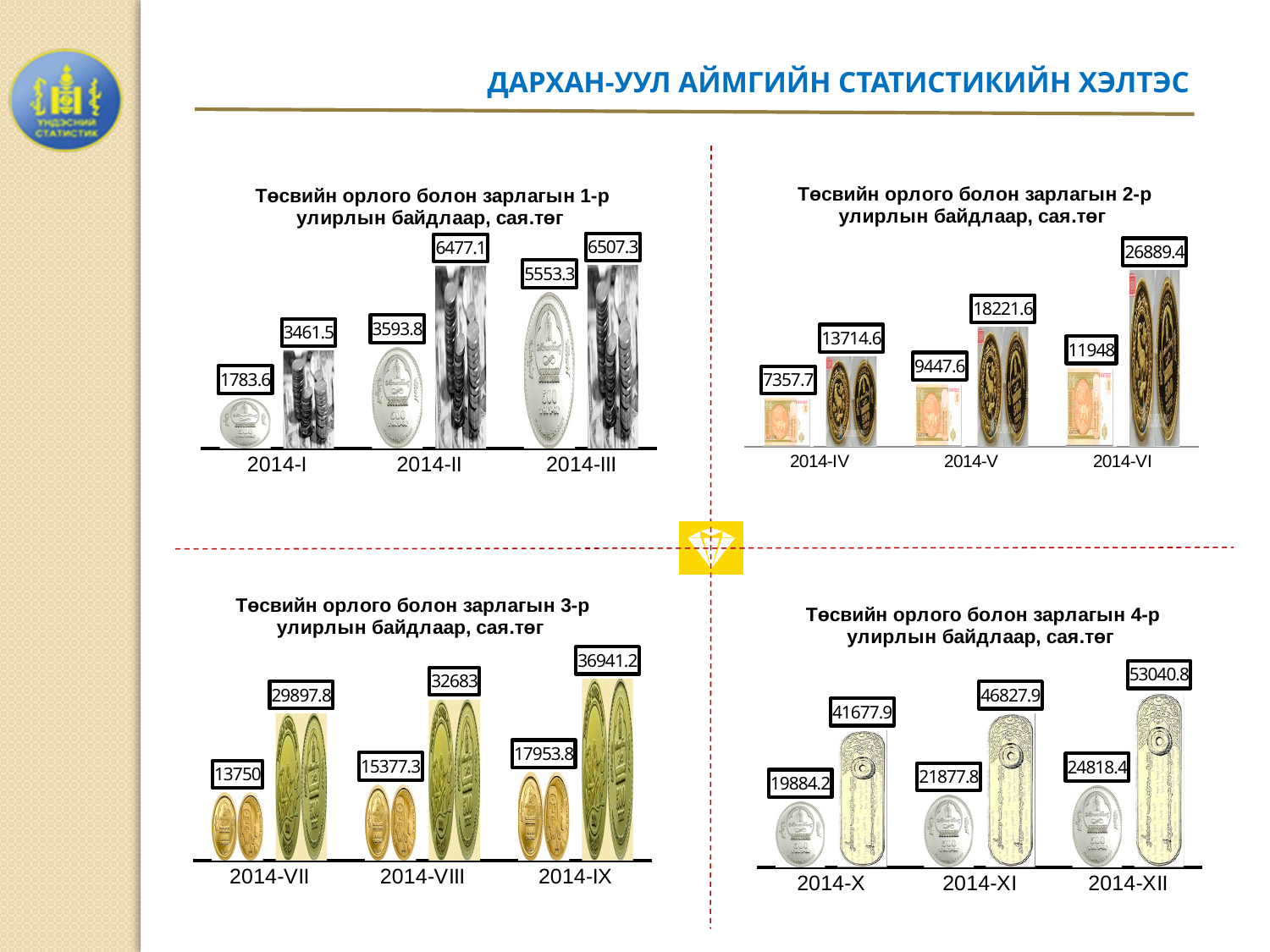
How many charts are shown on the slide? 4 In the bottom-left chart (3-р улирал), what is the value of the first bar for 2014-VII? 13750 In the top-left chart (1-р улирал), what is the value of the second bar for 2014-II? 6477.1 In the top-right chart (2-р улирал), what is the value of the first bar for 2014-V? 9447.6 In the bottom-left chart (3-р улирал), which category has the lowest second bar? 2014-VII In the top-left chart (1-р улирал), what is the value of the first bar for 2014-I? 1783.6 In the top-right chart (2-р улирал), which category has the highest second bar? 2014-VI In the bottom-right chart (4-р улирал), what is the value of the second bar for 2014-XII? 53040.8 In the top-right chart (2-р улирал), what is the value of the second bar for 2014-VI? 26889.4 In the top-left chart (1-р улирал), what is the difference between the two bars for 2014-III? 954 In the bottom-right chart (4-р улирал), which is larger: the first bar for 2014-XI or the first bar for 2014-X? 2014-XI In the bottom-right chart (4-р улирал), do the second-bar values rise or fall from 2014-X to 2014-XII? rise